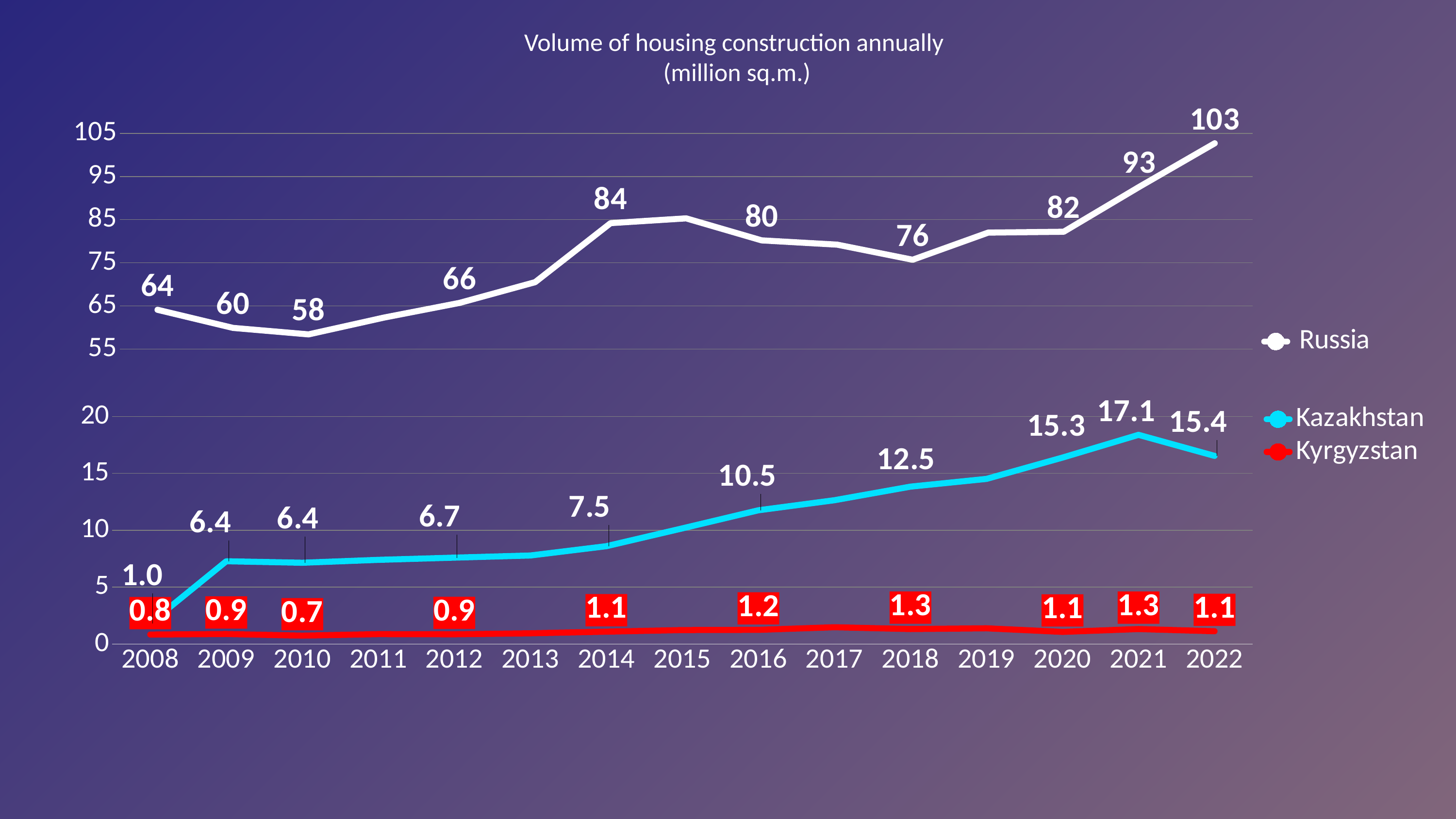
What is the difference between Kazakhstan's values in 2021 and 2022? 1.7 What is the difference between Russia's values in 2022 and 2021? 10 How many years are shown on the x axis? 15 What kind of chart is shown on the slide? Line chart How many series does the legend list? 3 Is the value for Russia in 2015 greater or less than 75? greater In which year does Kazakhstan reach its highest value? 2021 What is the value for Kazakhstan in 2018? 12.5 What is the value for Russia in 2022? 103 Which is larger, Russia's value in 2014 or in 2016? 2014 What is the value for Kyrgyzstan in 2010? 0.7 In which year does Russia have its lowest labelled value? 2010